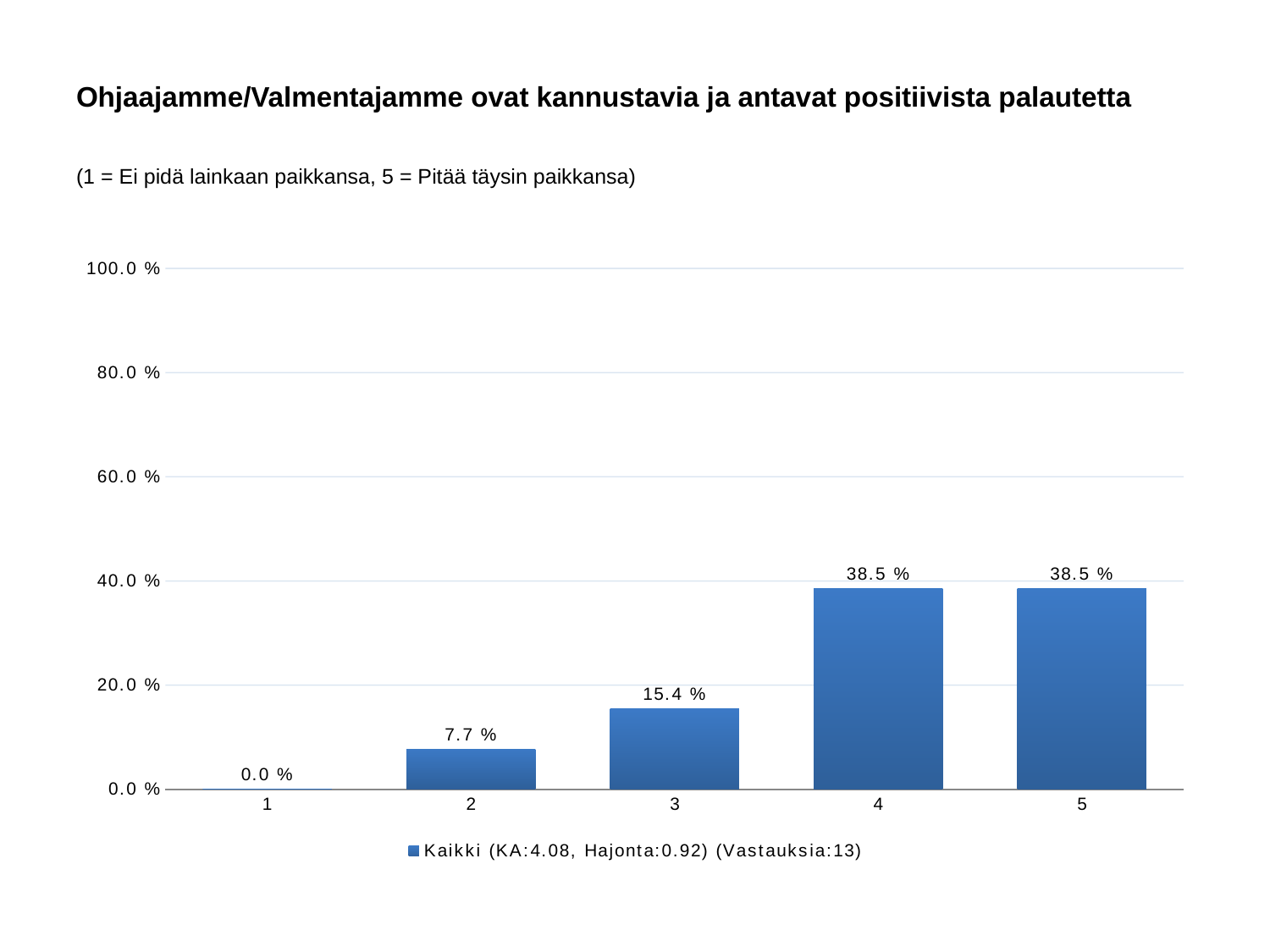
Which is larger, the value for category 2 or the value for category 3? 3 How many responses (Vastauksia) does the legend report? 13 Which category has the lowest value? 1 Is the value for category 4 greater or less than 20.0 %? greater What is the value for category 1? 0.0 % What is the value for category 3? 15.4 % What is the difference between the values for category 3 and category 2? 7.7 % What kind of chart is shown on the slide? bar chart What is the value for category 2? 7.7 % How many categories are shown on the x axis? 5 What is the difference between the values for category 4 and category 3? 23.1 % What is the value for category 5? 38.5 %